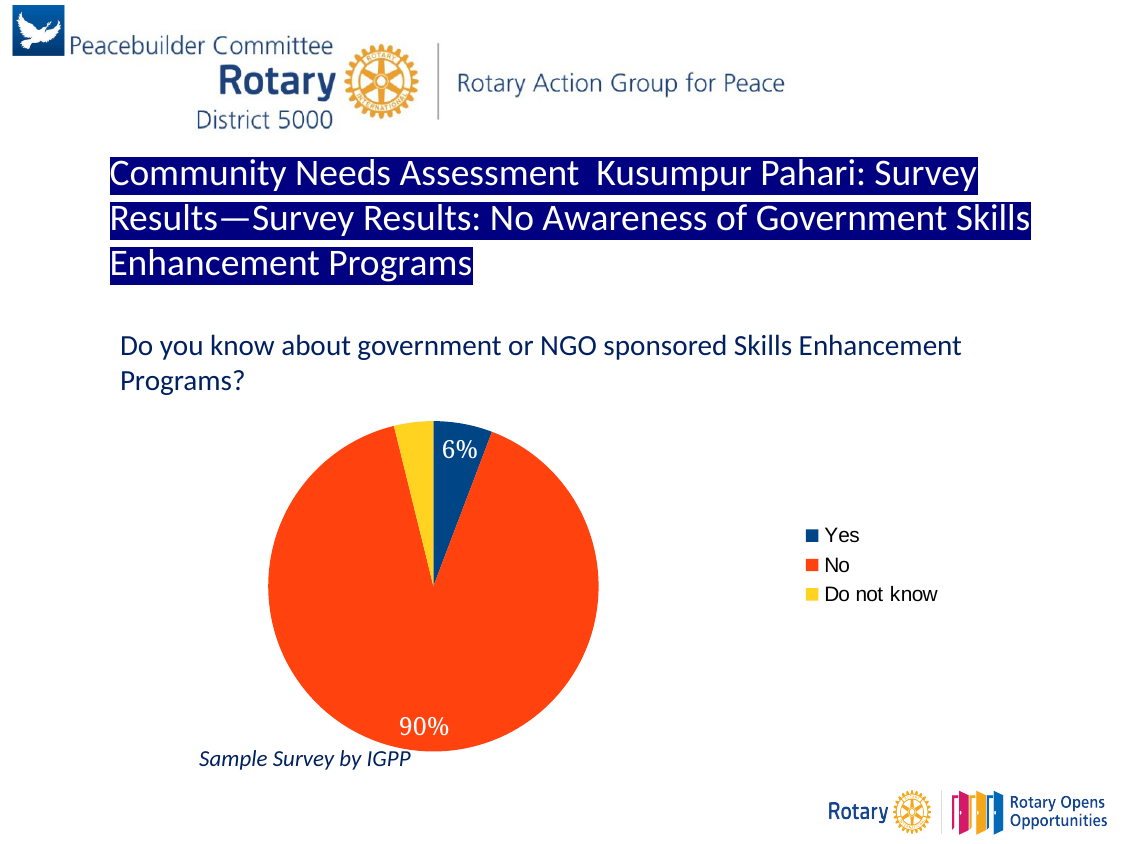
What share of respondents answered "Yes" in the pie chart? 6% Which response has the largest slice of the pie chart? No What survey question does the pie chart present results for? Do you know about government or NGO sponsored Skills Enhancement Programs? By how many percentage points does the "No" share exceed the "Yes" share? 84 percentage points What kind of chart is shown on the slide? Pie chart How many entries does the legend list? 3 What colour represents the "No" response in the pie chart? Orange-red Which response has the smallest slice of the pie chart? Do not know What share of respondents answered "No" in the pie chart? 90% Which slice is larger, "Yes" or "No"? No How many response categories are shown in the pie chart? 3